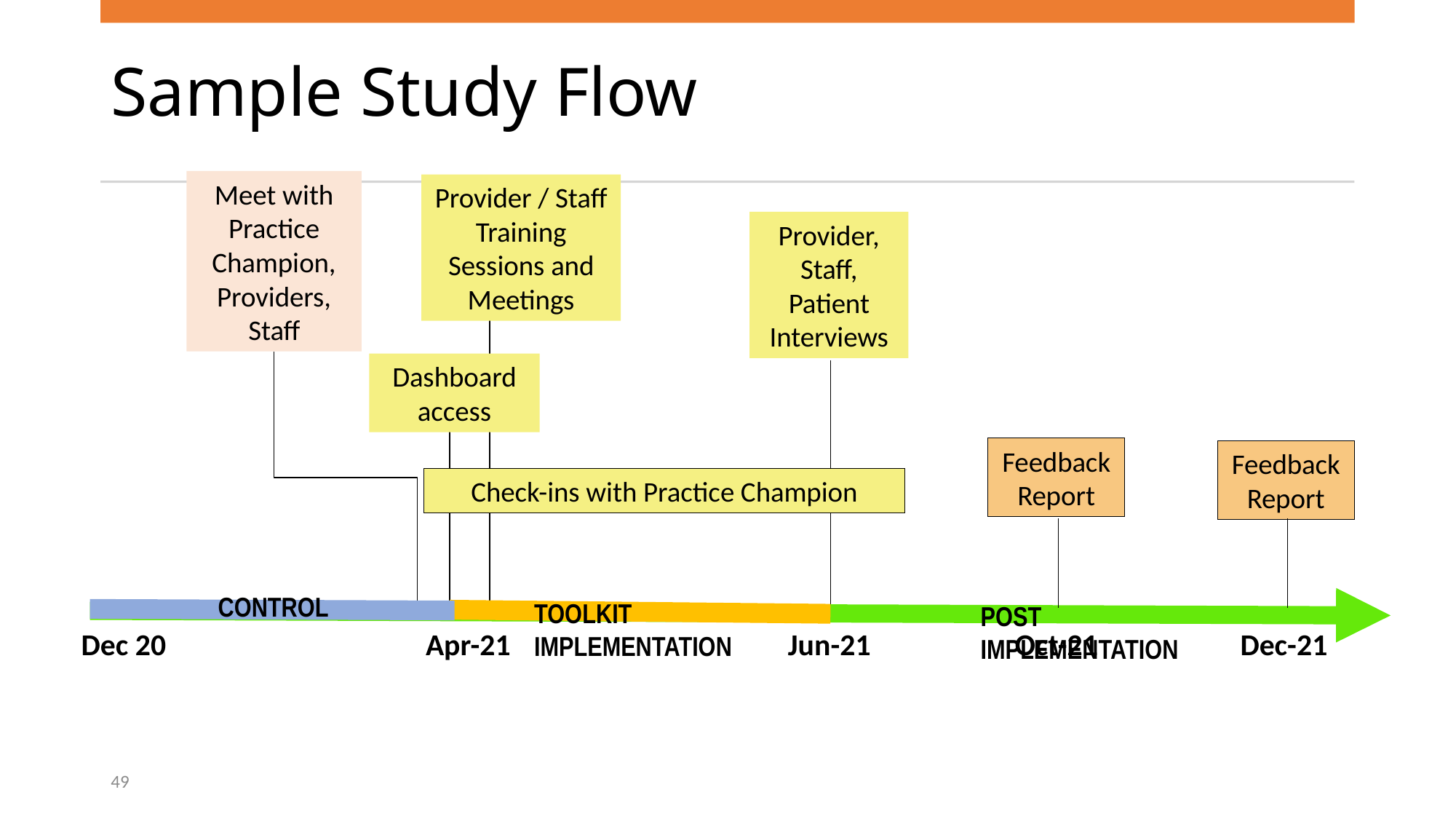
How many phases are labelled along the timeline arrow? 3 What activity is marked on the timeline at Oct-21? Feedback Report What is the first date shown on the timeline? Dec 20 Which phase of the timeline runs from Apr-21 to Jun-21? TOOLKIT IMPLEMENTATION What activity is marked on the timeline at Dec-21? Feedback Report Which phase of the timeline begins at Jun-21? POST IMPLEMENTATION Which phase of the timeline runs from Dec 20 to Apr-21? CONTROL How many date labels are shown along the timeline? 5 What is the title of the slide containing the timeline? Sample Study Flow What colour is the CONTROL segment of the timeline? Blue What is the last date shown on the timeline? Dec-21